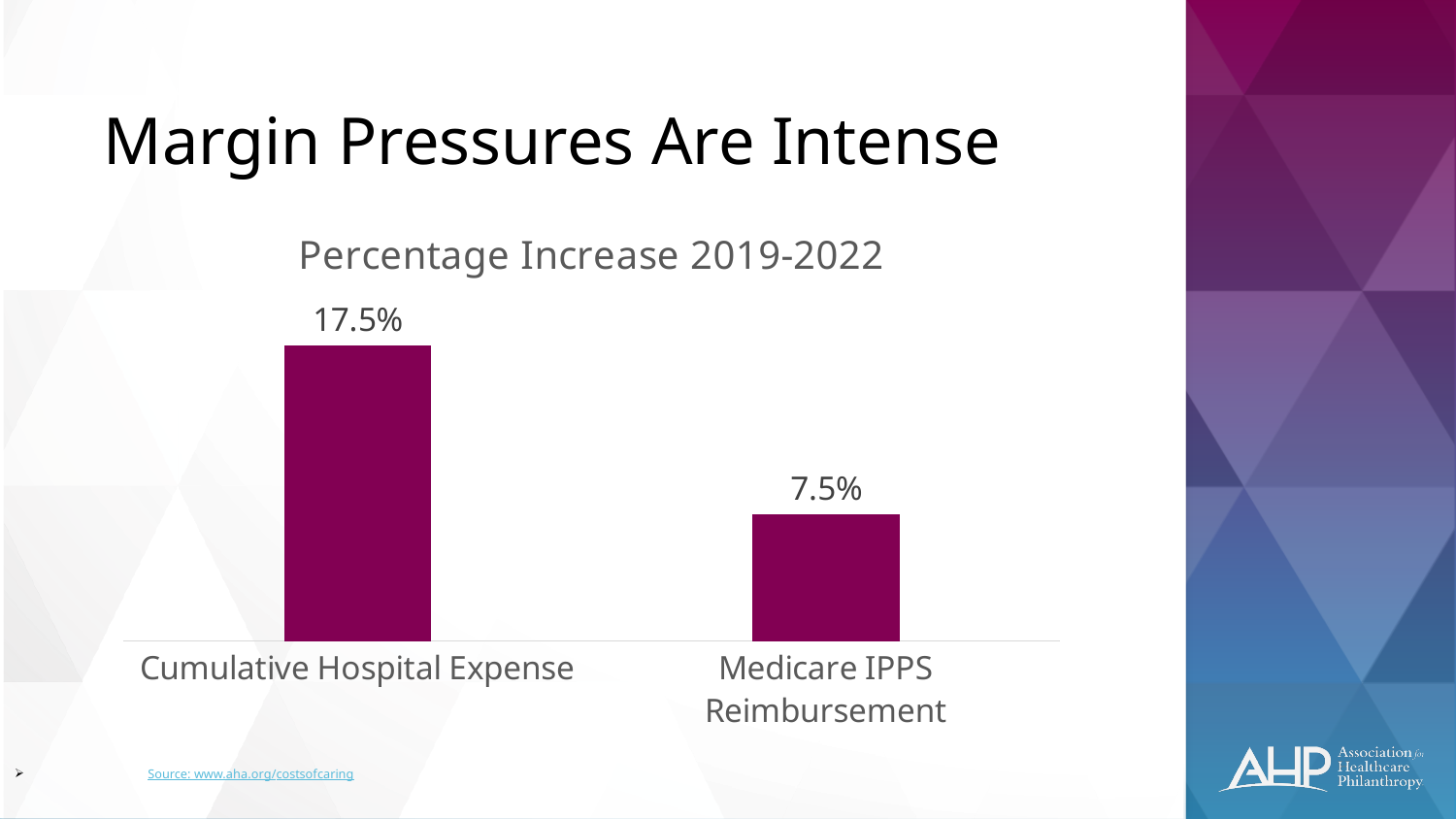
What colour are the bars in the chart? Purple Which category has the lowest percentage increase? Medicare IPPS Reimbursement What is the title of the chart? Percentage Increase 2019-2022 What is the percentage increase for Cumulative Hospital Expense? 17.5% Which is larger: the percentage increase for Cumulative Hospital Expense or for Medicare IPPS Reimbursement? Cumulative Hospital Expense What is the difference between the percentage increase for Cumulative Hospital Expense and Medicare IPPS Reimbursement? 10.0% How many categories are shown in the chart? 2 What is the percentage increase for Medicare IPPS Reimbursement? 7.5% Which category has the highest percentage increase? Cumulative Hospital Expense What kind of chart is shown on the slide? Bar chart